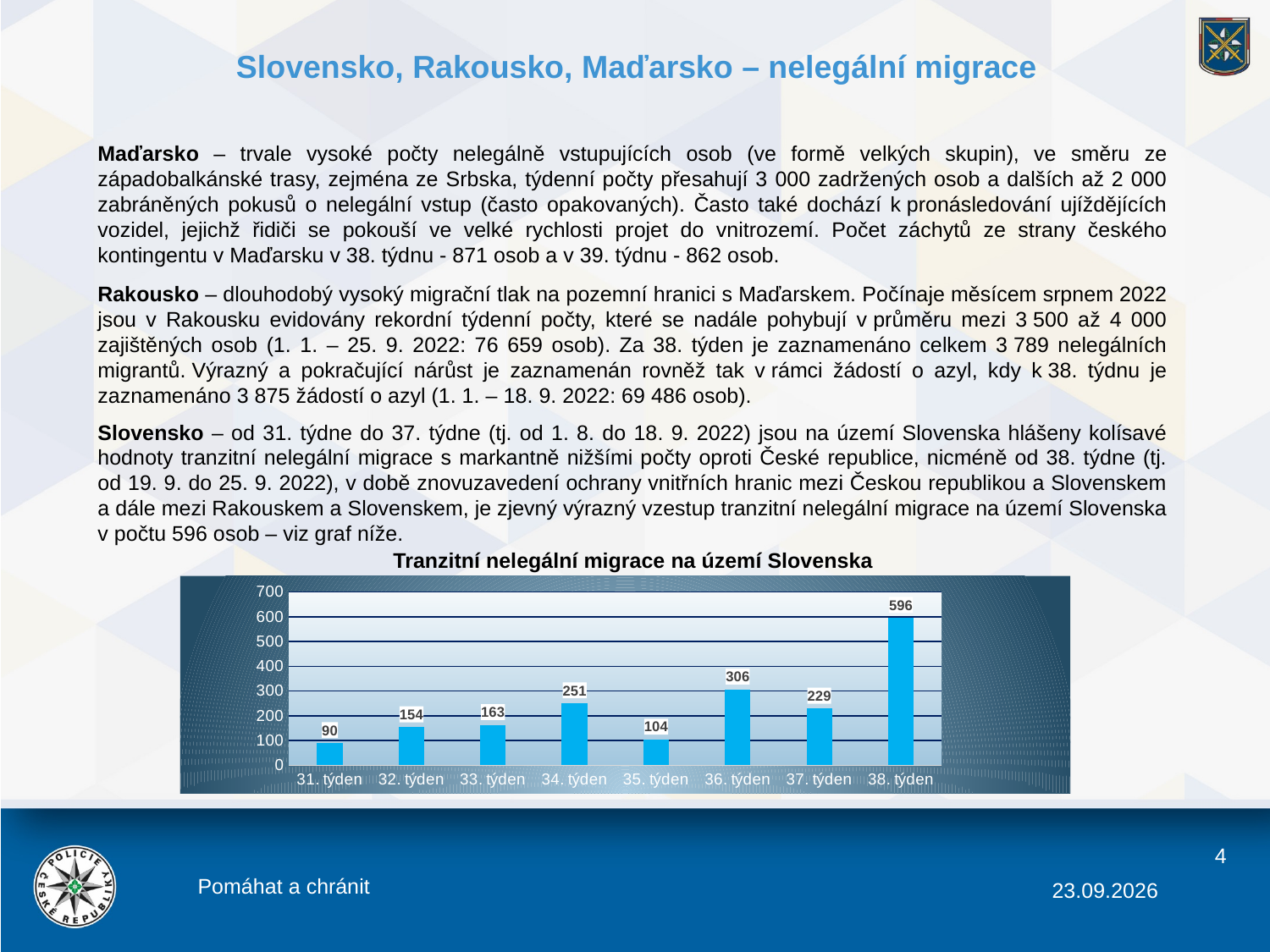
Is the value for 36. týden greater or less than 400? less What is the title of the chart? Tranzitní nelegální migrace na území Slovenska Which week has the highest value in the chart? 38. týden Which week has the lowest value in the chart? 31. týden What is the value for 38. týden in the chart? 596 What is the value for 31. týden in the chart? 90 What is the difference between the values for 33. týden and 32. týden? 9 How many weeks are shown on the x axis of the chart? 8 Which is larger, the value for 34. týden or the value for 35. týden? 34. týden What kind of chart is shown on the slide? bar chart What is the difference between the values for 38. týden and 37. týden? 367 What is the value for 36. týden in the chart? 306